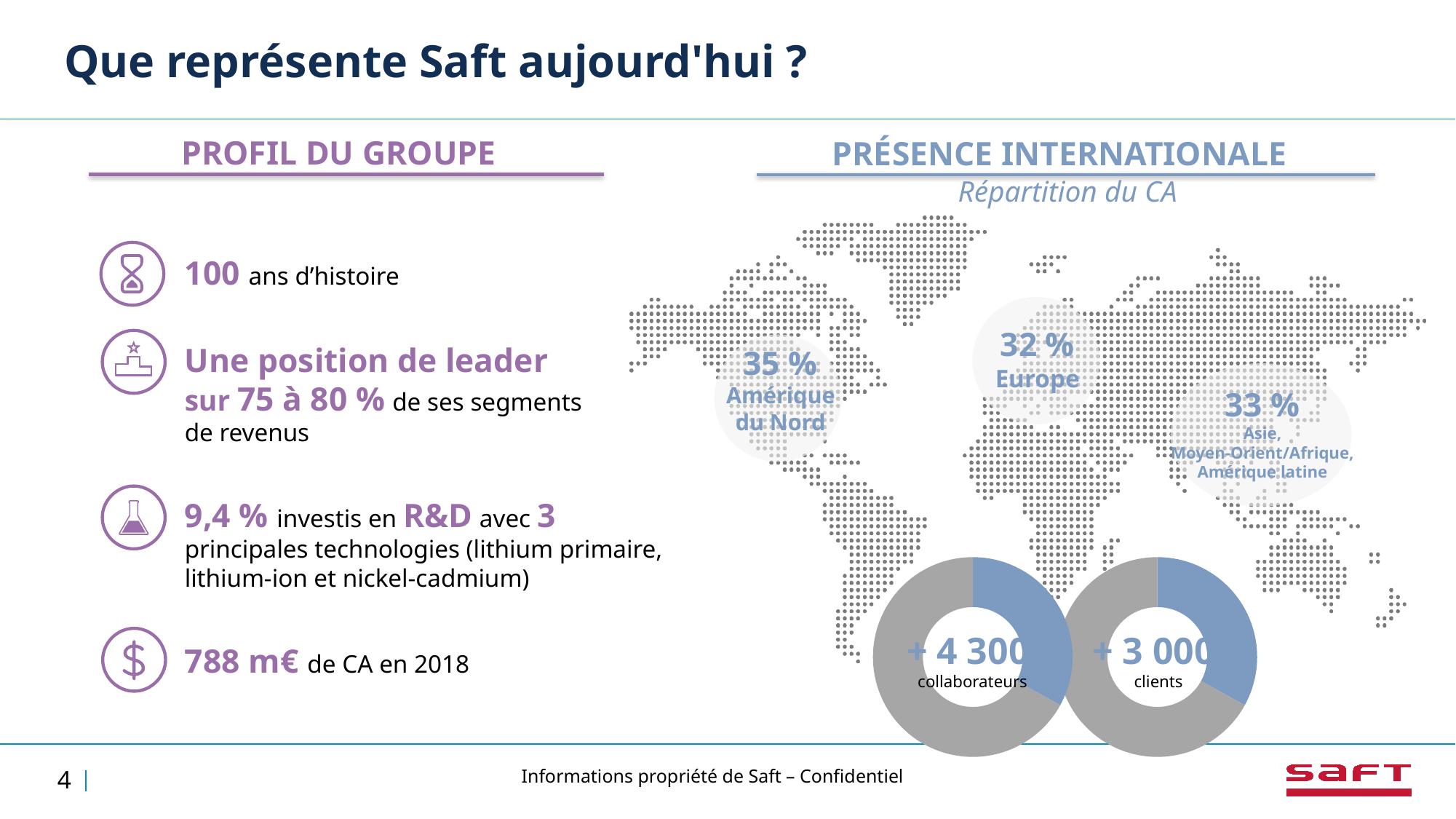
What is the label in the centre of the right donut chart at the bottom right? + 3 000 clients In the 'Répartition du CA' map, which share is larger: Europe or Asie, Moyen-Orient/Afrique, Amérique latine? Asie, Moyen-Orient/Afrique, Amérique latine What is the subtitle under 'PRÉSENCE INTERNATIONALE' that describes the map? Répartition du CA In the 'Répartition du CA' map, what share of revenue comes from Europe? 32 % What is the label in the centre of the left donut chart at the bottom right? + 4 300 collaborateurs In the 'Répartition du CA' map, which region has the highest share of revenue? Amérique du Nord How many regions are shown in the 'Répartition du CA' map? 3 In the 'Répartition du CA' map, what share of revenue comes from Asie, Moyen-Orient/Afrique, Amérique latine? 33 % In the 'Répartition du CA' map, what share of revenue comes from Amérique du Nord? 35 % In the 'Répartition du CA' map, which region has the lowest share of revenue? Europe In the 'Répartition du CA' map, what is the difference between the Amérique du Nord share and the Europe share? 3 % What kind of charts are the two charts at the bottom right of the slide? Donut charts